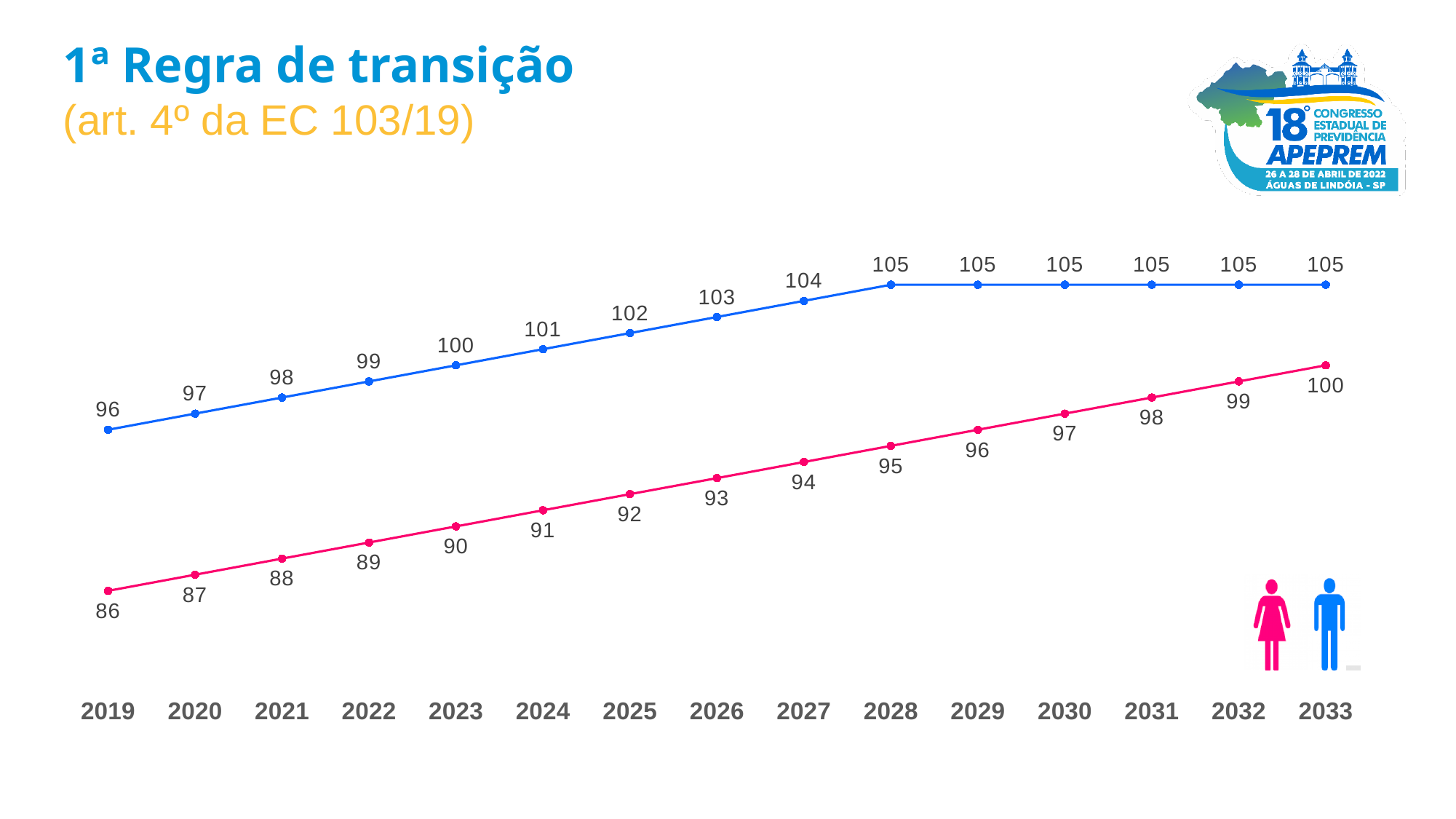
What is the difference between the blue line and the pink line in 2019? 10 From 2028 to 2033, does the blue line rise, fall, or stay flat? stay flat What is the lowest value on the pink line, and in which year does it occur? 86, in 2019 How many years are shown on the x axis? 15 What is the highest value reached by the blue line? 105 What is the value of the blue line in 2028? 105 What kind of chart is shown on the slide? line chart What is the value of the pink line in 2033? 100 What is the value of the pink line in 2025? 92 What is the difference between the blue line and the pink line in 2033? 5 Which line has the higher value in 2030, the blue or the pink? blue What is the value of the blue line in 2019? 96